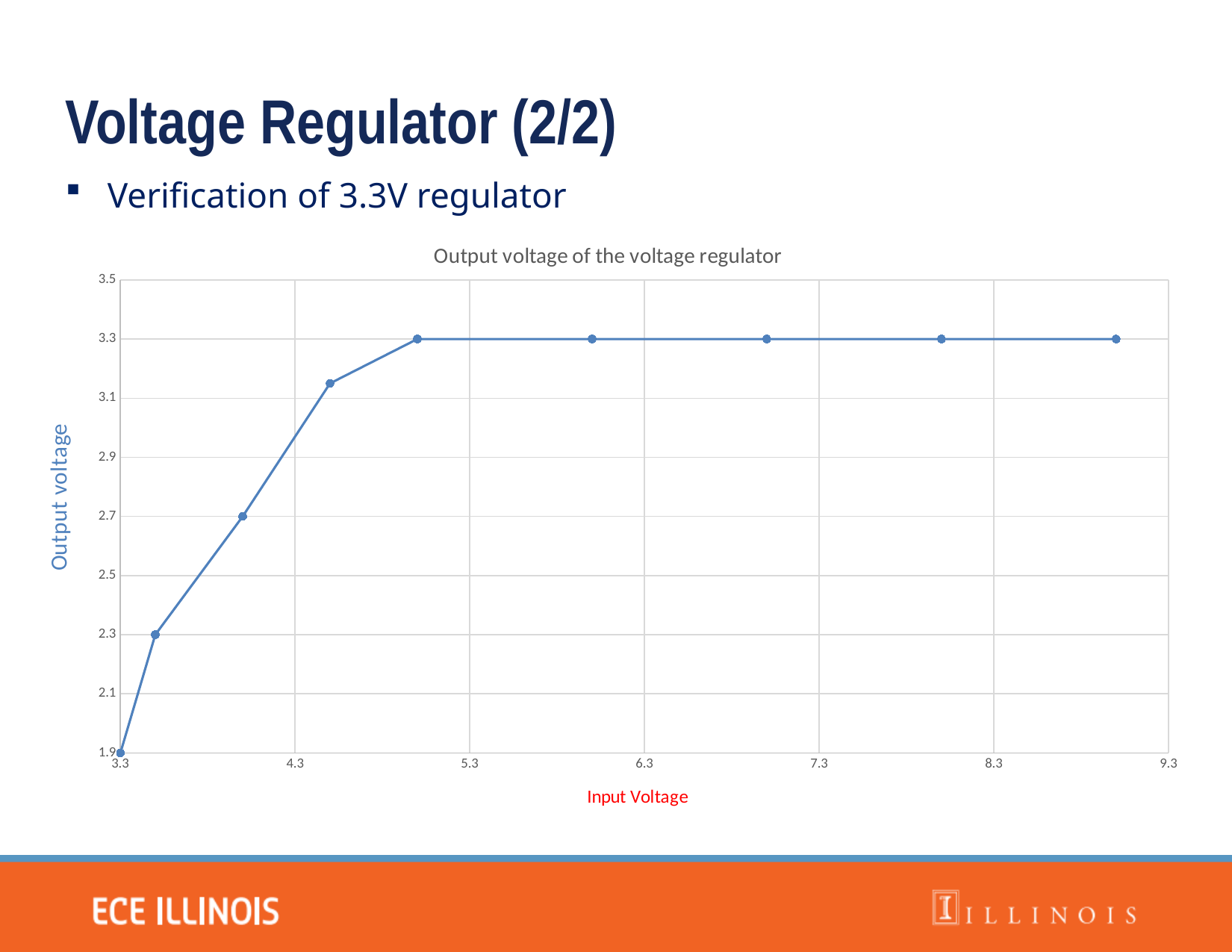
What is the title of the chart? Output voltage of the voltage regulator What kind of chart is shown on the slide? line chart What is the highest output voltage reached on the chart? 3.3 What is the difference between the highest and lowest output voltages on the chart? 1.4 What is the label of the x axis? Input Voltage Is the output voltage at the second data point greater or less than 2.5? less What is the lowest output voltage shown on the chart? 1.9 What is the output voltage at an input voltage of 3.3? 1.9 How many data points are plotted on the line? 9 Which is larger, the output voltage at the first data point or at the last data point? the last data point Does the output voltage rise or fall as the input voltage increases from 3.3 to about 5? rise Is the output voltage at the fourth data point greater or less than 3.1? greater